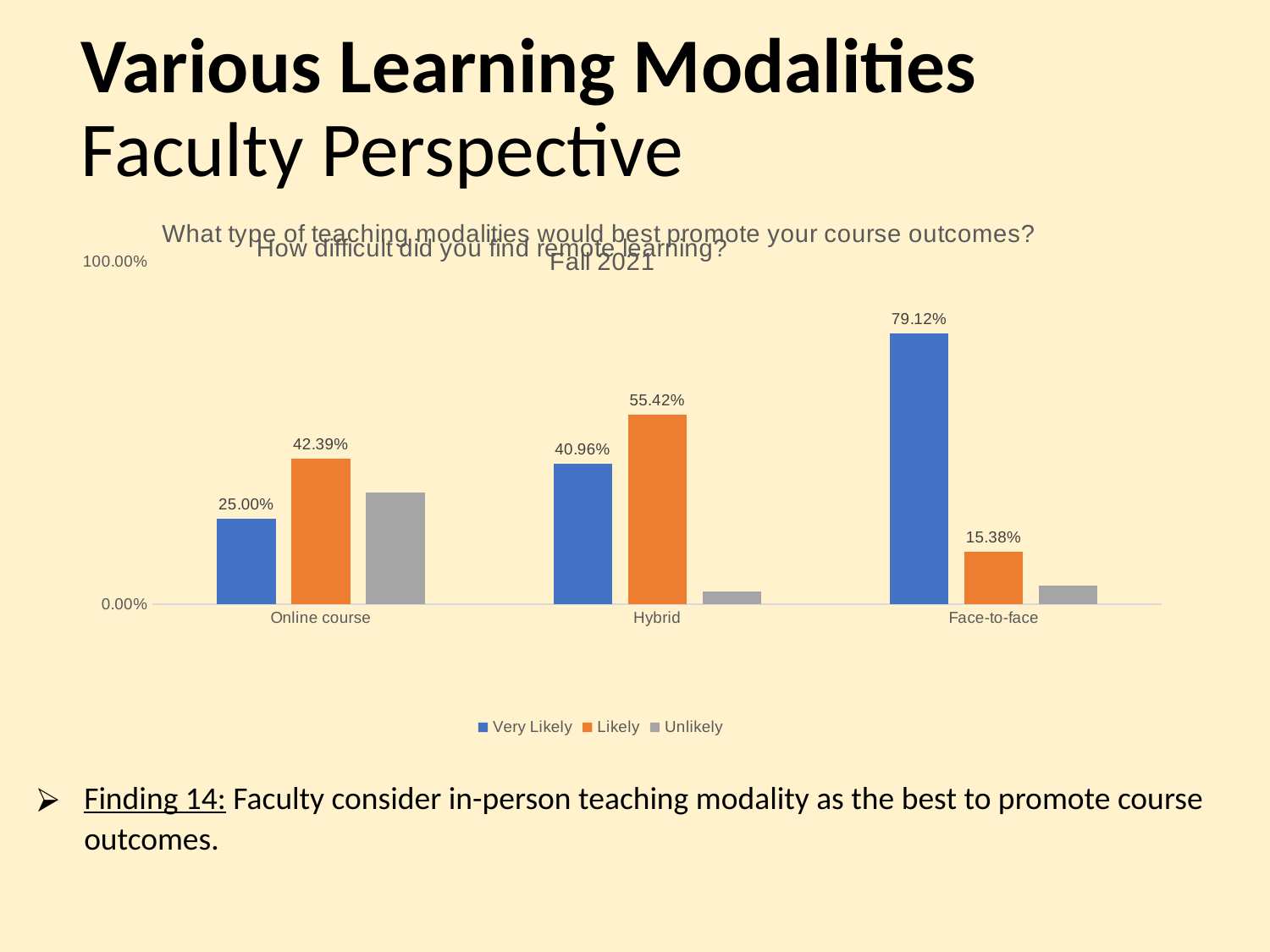
What is the Very Likely value for Online course? 25.00% What kind of chart is shown on the slide? Bar chart For Hybrid, which is larger: the Very Likely value or the Likely value? Likely Which teaching modality has the lowest Likely value? Face-to-face What is the Very Likely value for Face-to-face? 79.12% How many teaching modalities are shown on the x axis? 3 How many series does the legend list? 3 What is the difference between the Very Likely and Likely values for Face-to-face? 63.74% What is the Likely value for Face-to-face? 15.38% Which teaching modality has the highest Very Likely value? Face-to-face What is the Likely value for Hybrid? 55.42% What is the Likely value for Online course? 42.39%